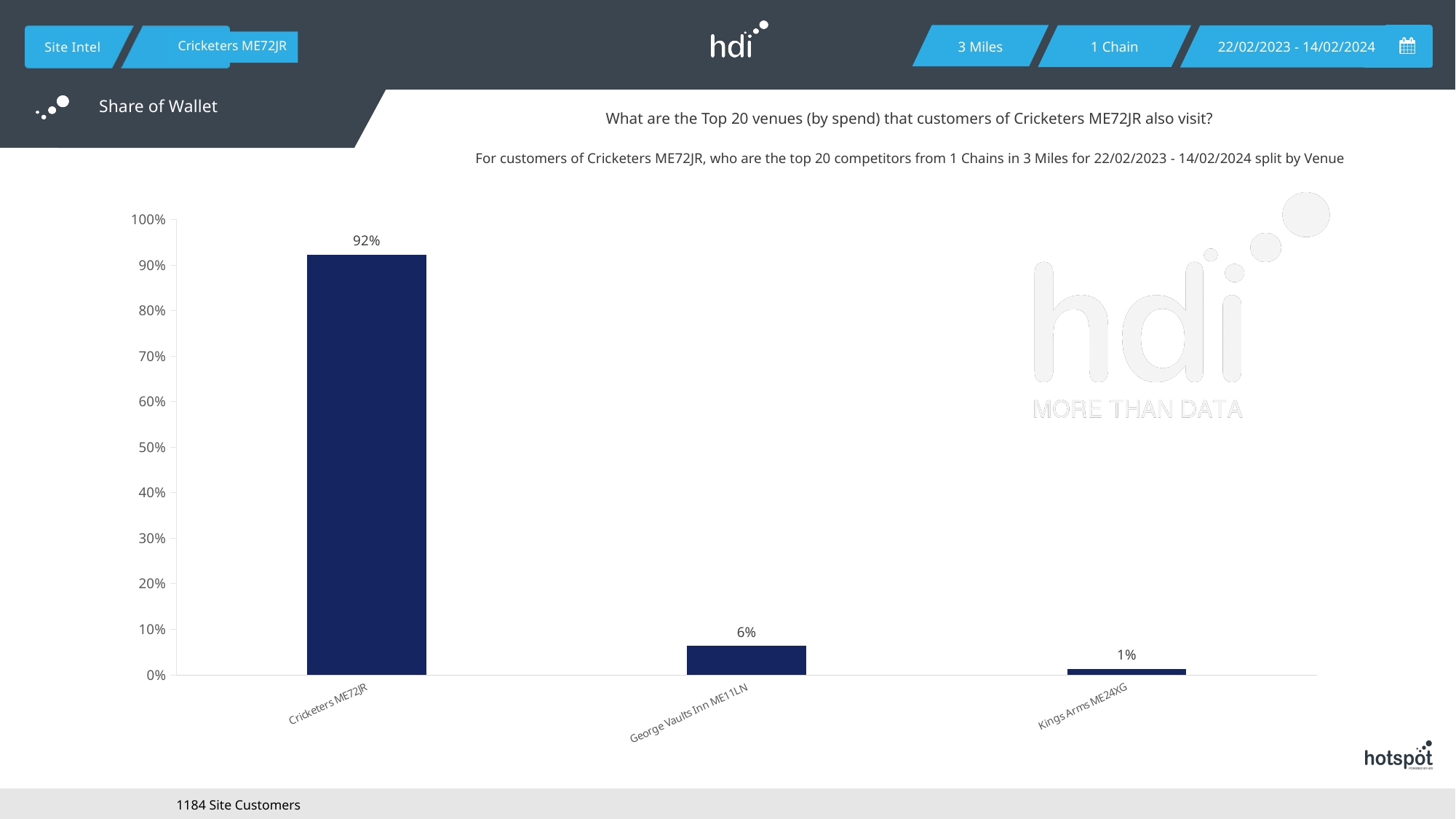
What is the value for Cricketers ME72JR? 92% Which venue has the highest value? Cricketers ME72JR What is the difference between the values for Cricketers ME72JR and George Vaults Inn ME11LN? 86% What is the value for George Vaults Inn ME11LN? 6% How many venues are shown on the chart? 3 What is the value for Kings Arms ME24XG? 1% Is the value for Cricketers ME72JR greater or less than 90%? greater What is the difference between the values for George Vaults Inn ME11LN and Kings Arms ME24XG? 5% Which is larger, the value for George Vaults Inn ME11LN or Kings Arms ME24XG? George Vaults Inn ME11LN Do the values rise or fall from left to right along the x axis? fall Which venue has the lowest value? Kings Arms ME24XG What kind of chart is shown on the slide? bar chart